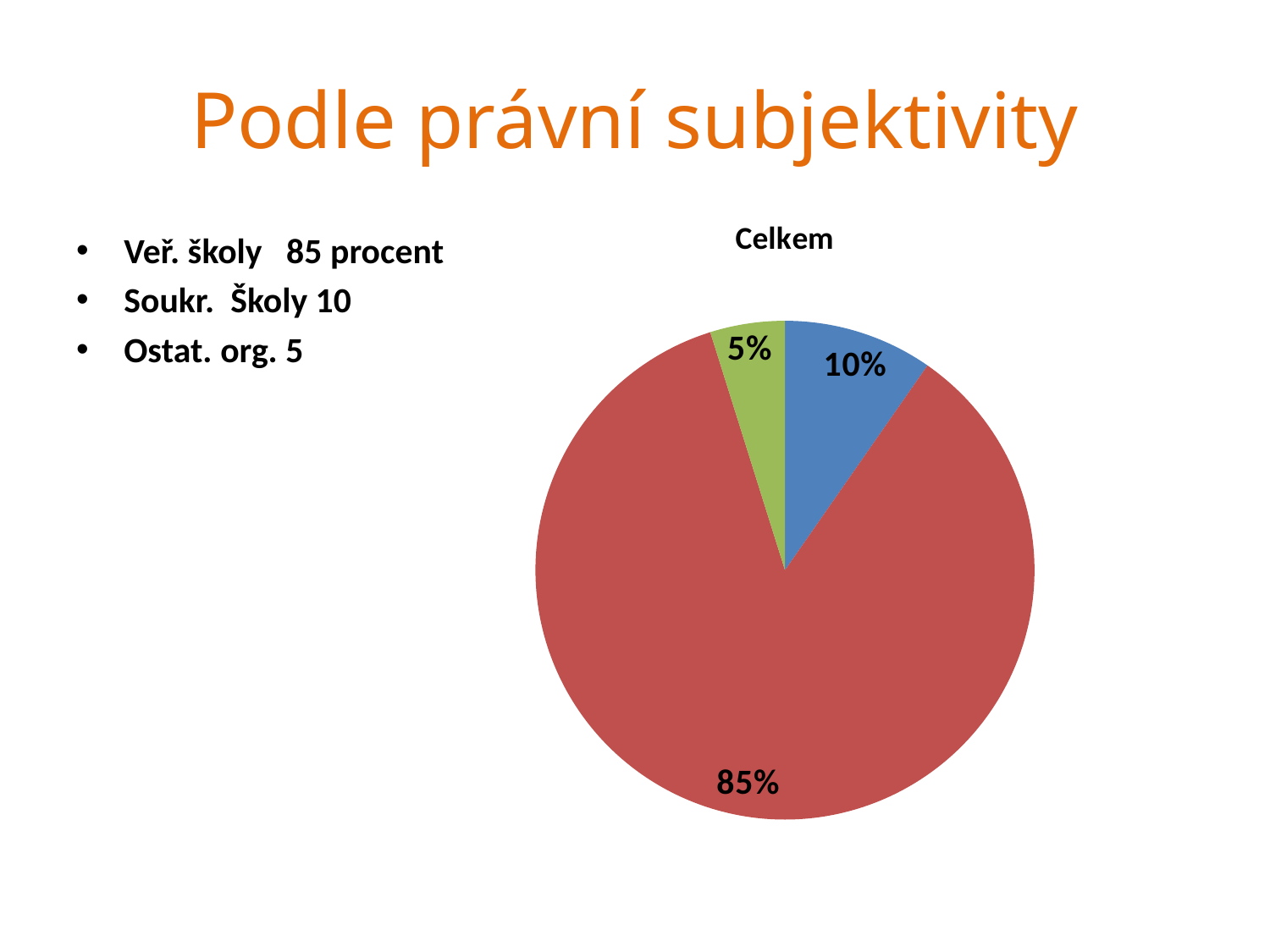
How many slices does the pie chart have? 3 What is the title of the chart? Celkem What is the difference between the blue slice and the green slice? 5% What percentage is shown on the green slice of the pie chart? 5% What kind of chart is shown on the slide? pie chart Which slice of the pie chart is the largest? the red slice (85%) Which slice of the pie chart is the smallest? the green slice (5%) What percentage is shown on the blue slice of the pie chart? 10% What percentage is shown on the largest (red) slice of the pie chart? 85% What colour is the slice labelled 85%? red What is the difference between the largest slice and the smallest slice of the pie chart? 80% Which is larger, the blue slice or the green slice? the blue slice